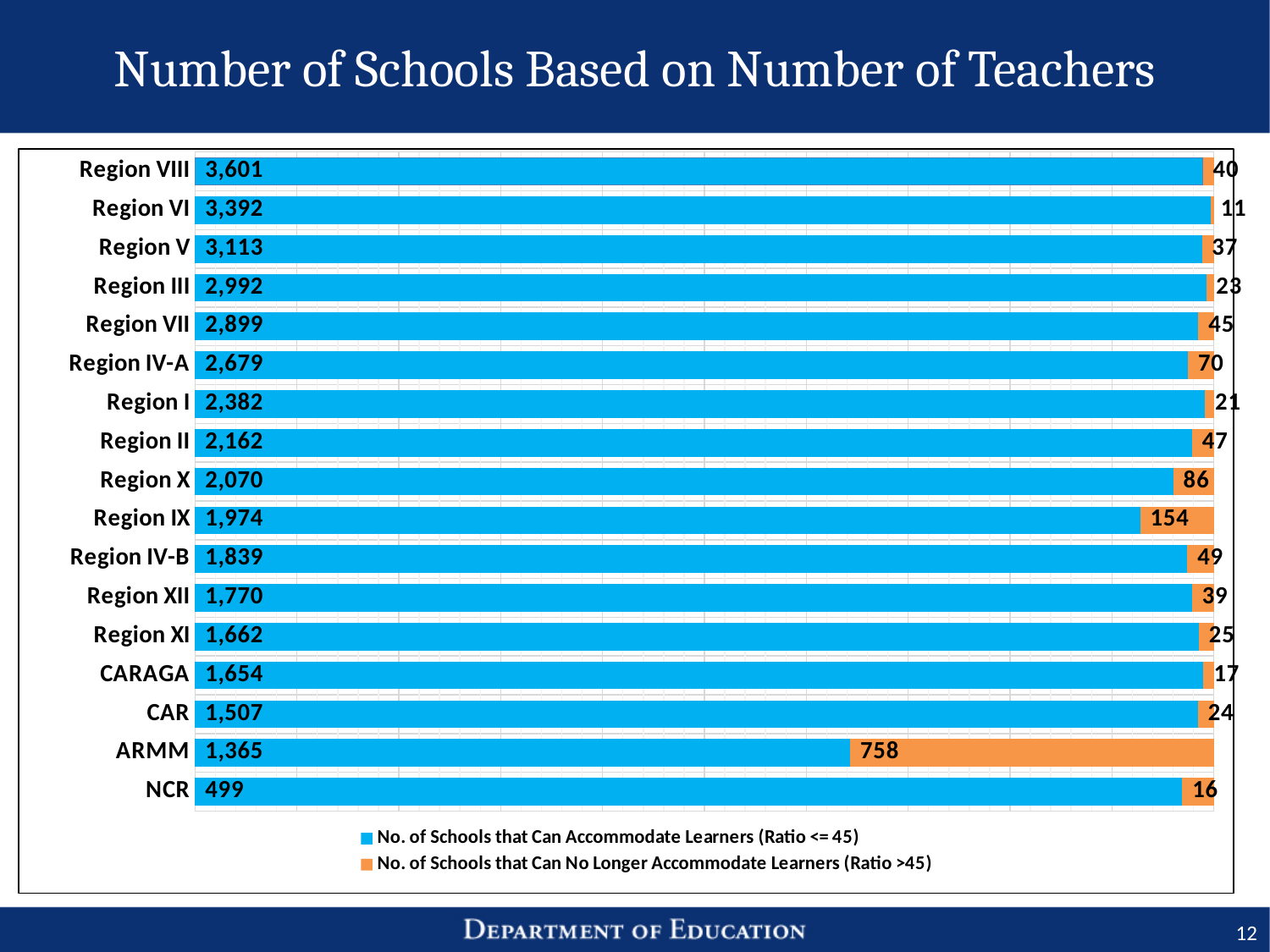
What is the total number of schools in ARMM across both series? 2,123 What is the difference between the number of schools that can accommodate learners in Region VIII and in Region VI? 209 Which has more schools that can no longer accommodate learners (Ratio >45): Region IX or Region X? Region IX Which region has the lowest number of schools that can no longer accommodate learners (Ratio >45)? Region VI How many regions are shown in the chart? 17 What is the number of schools that can no longer accommodate learners (Ratio >45) in ARMM? 758 What is the number of schools that can accommodate learners (Ratio <= 45) in Region V? 3,113 Which region has the highest number of schools that can accommodate learners (Ratio <= 45)? Region VIII How many series does the legend list? 2 What type of chart is shown on the slide? bar chart Which region has the highest number of schools that can no longer accommodate learners (Ratio >45)? ARMM Which region has the lowest number of schools that can accommodate learners (Ratio <= 45)? NCR